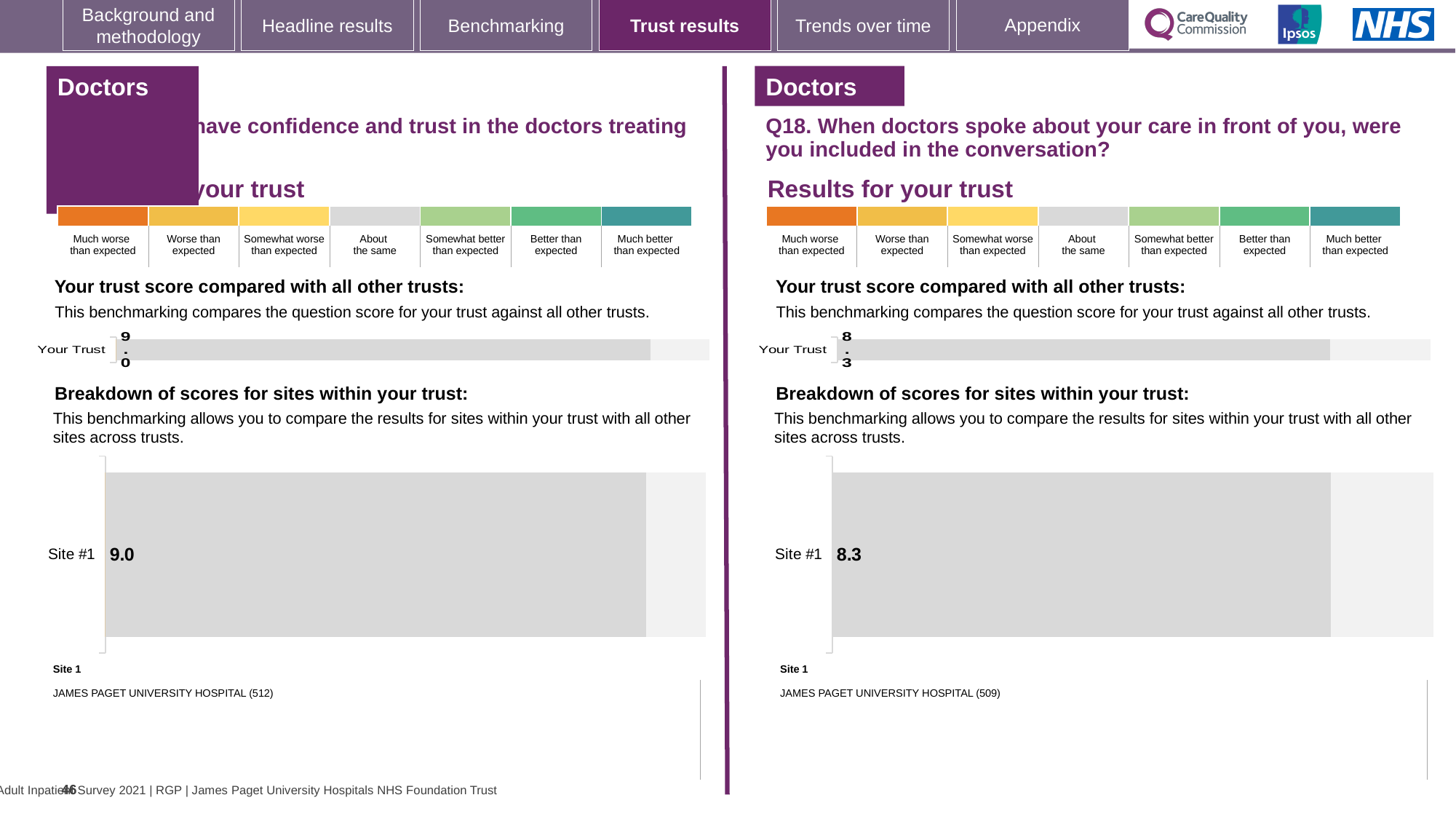
Which is larger: the Site #1 score on the left panel or the Site #1 score on the right panel (Q18)? Left panel (9.0) On the right panel (Q18), which site name is listed as Site 1 below the breakdown chart? JAMES PAGET UNIVERSITY HOSPITAL (509) On the right panel (Q18), what score is shown for Site #1 in the 'Breakdown of scores for sites within your trust' chart? 8.3 On the left panel, is the Your Trust score greater or less than 8? greater How many sites are plotted in the 'Breakdown of scores for sites within your trust' chart on the right panel (Q18)? 1 On the right panel, is the Site #1 score for Q18 greater or less than 8? greater On the right panel (Q18), what is the value shown for Your Trust in the 'Your trust score compared with all other trusts' chart? 8.3 What is the difference between the Your Trust score on the left panel and the Your Trust score on the right panel (Q18)? 0.7 On the left panel, what is the value shown for Your Trust in the 'Your trust score compared with all other trusts' chart? 9.0 On the left panel, what score is shown for Site #1 in the 'Breakdown of scores for sites within your trust' chart? 9.0 On the left panel, which site name is listed as Site 1 below the breakdown chart? JAMES PAGET UNIVERSITY HOSPITAL (512) What type of chart is used to show the Site #1 score on the left panel? Bar chart